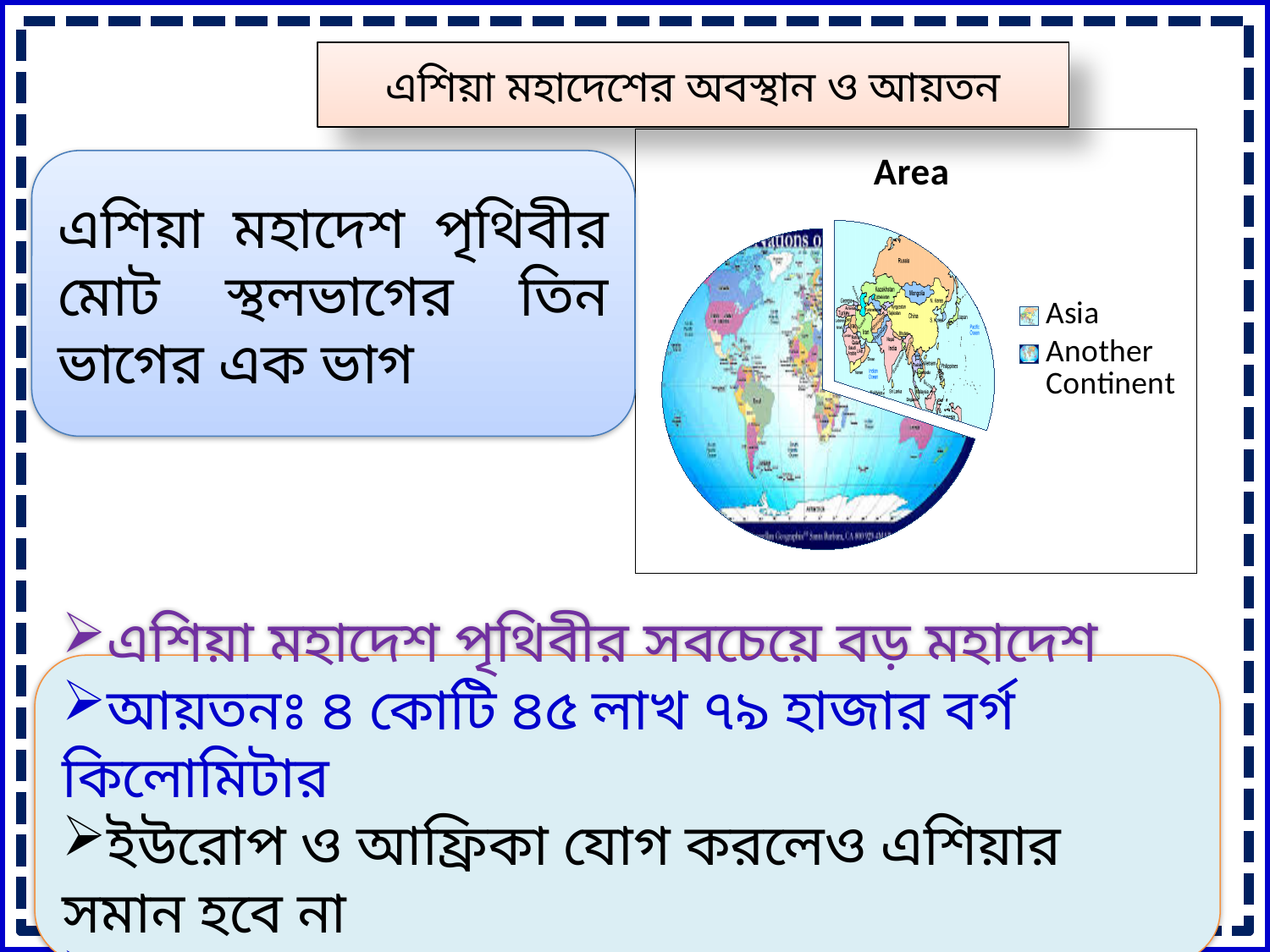
What kind of chart is shown on the slide? pie chart What are the two categories listed in the chart's legend? Asia and Another Continent Which category has the largest slice in the pie chart? Another Continent What is the title of the chart? Area How many slices does the pie chart have? 2 How many entries does the chart's legend list? 2 Which category has the smallest slice in the pie chart? Asia Which slice of the pie chart is larger, Asia or Another Continent? Another Continent